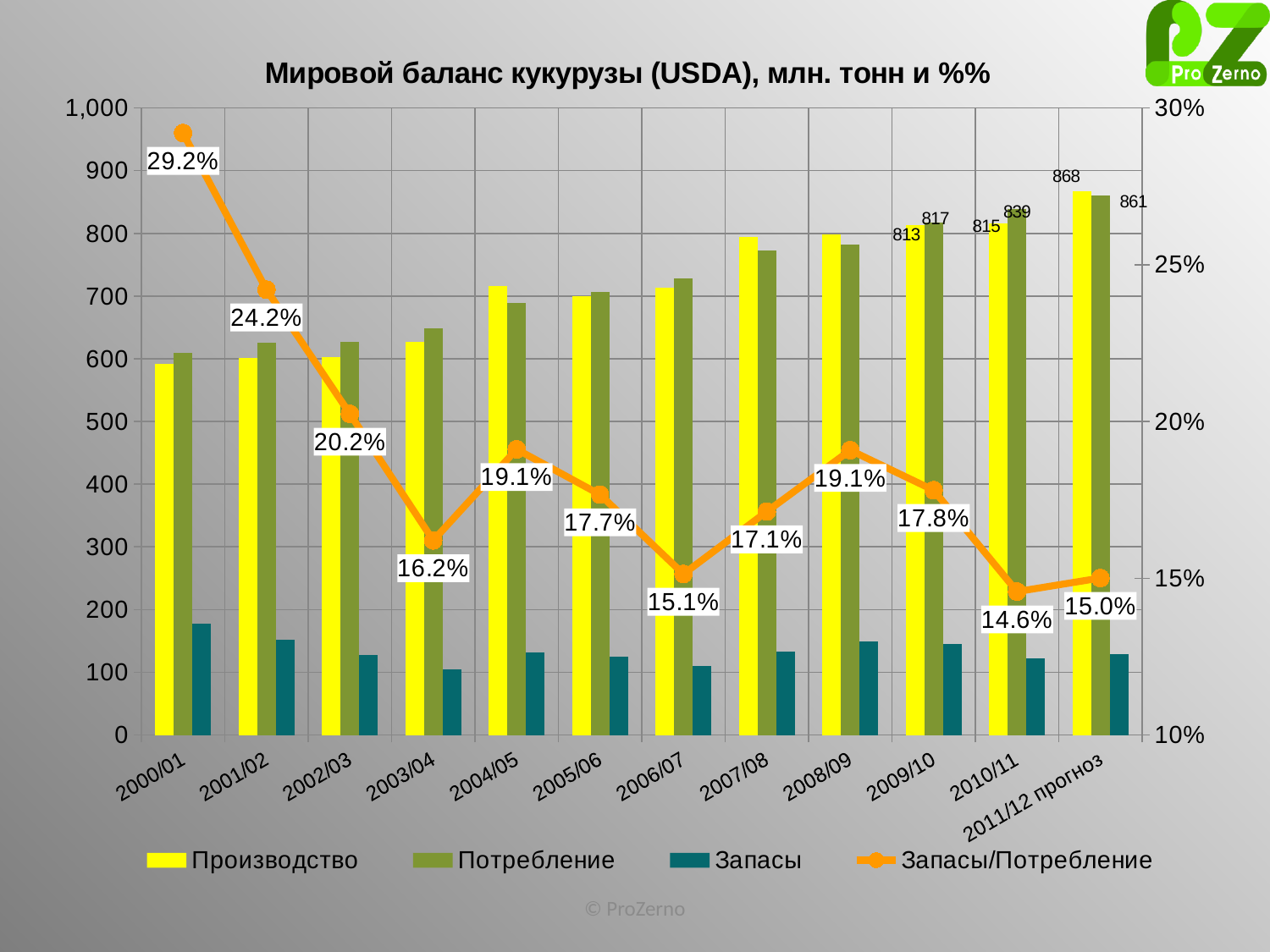
In which season is Запасы/Потребление highest? 2000/01 What is the difference between Потребление and Производство in 2010/11? 24 How many seasons are shown on the x axis? 12 How many series does the legend list? 4 By how much does Производство exceed Потребление in 2011/12 прогноз? 7 What is the value of Производство for 2011/12 прогноз? 868 In which season is Запасы/Потребление lowest? 2010/11 Is the value of Запасы for 2000/01 greater or less than 200? less Does Запасы/Потребление rise or fall from 2000/01 to 2003/04? fall What is the value of Потребление for 2010/11? 839 What is the value of Запасы/Потребление for 2000/01? 29.2% In 2009/10, which is larger: Производство or Потребление? Потребление